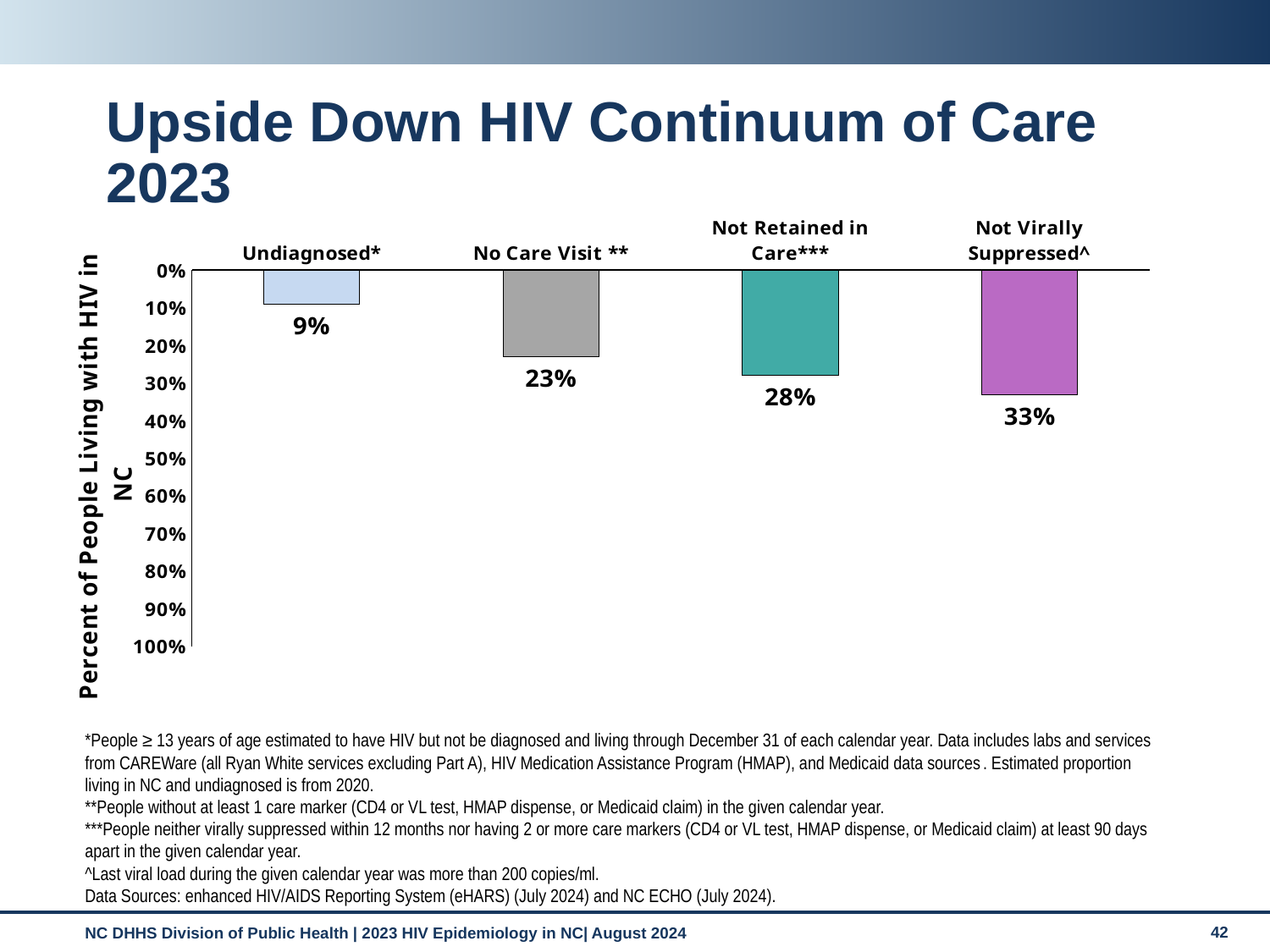
How many categories are shown in the chart? 4 Do the values rise or fall moving from left to right across the categories? Rise What is the value for Not Virally Suppressed^? 33% What is the difference between the values for Not Virally Suppressed^ and Undiagnosed*? 24% What kind of chart is shown on the slide? Bar chart What is the value for Undiagnosed*? 9% What is the value for No Care Visit **? 23% Which is larger, the value for No Care Visit ** or the value for Not Retained in Care***? Not Retained in Care*** Which category has the lowest value? Undiagnosed* What is the value for Not Retained in Care***? 28% What is the label of the vertical axis? Percent of People Living with HIV in NC Which category has the highest value? Not Virally Suppressed^